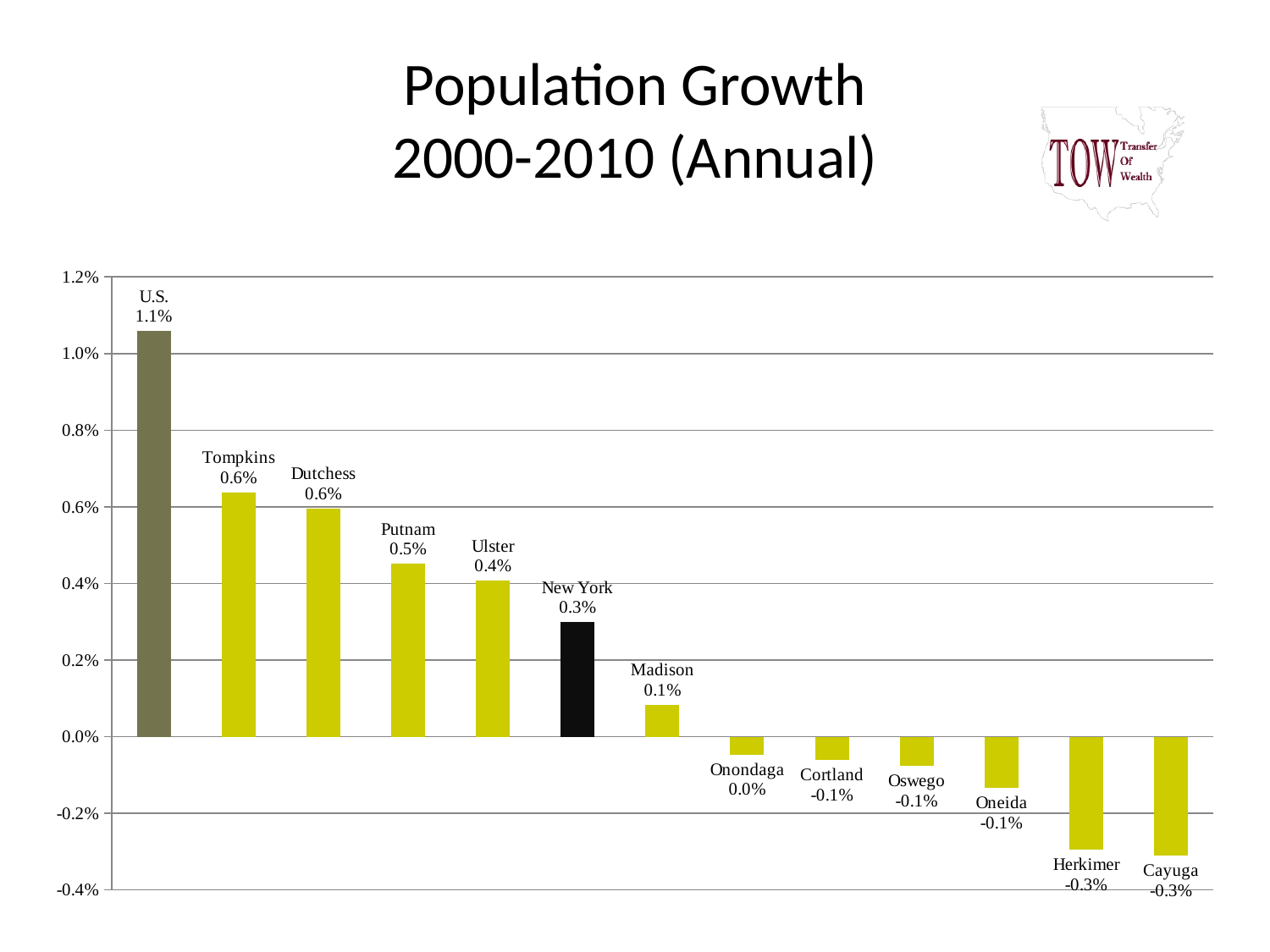
Do the values generally rise or fall moving from left to right along the x axis? Fall What is the difference between the Putnam value and the Madison value? 0.4% What kind of chart is shown on the slide? Bar chart Which category has the highest annual population growth on the chart? U.S. What is the difference between the U.S. value and the New York value? 0.8% Is the value for Tompkins greater or less than 0.4%? greater What is the annual population growth value shown for the U.S.? 1.1% Which has the larger annual population growth, Putnam or Ulster? Putnam What is the annual population growth value shown for New York? 0.3% What is the annual population growth value shown for Putnam? 0.5% How many categories (bars) are shown on the chart? 13 What is the annual population growth value shown for Herkimer? -0.3%